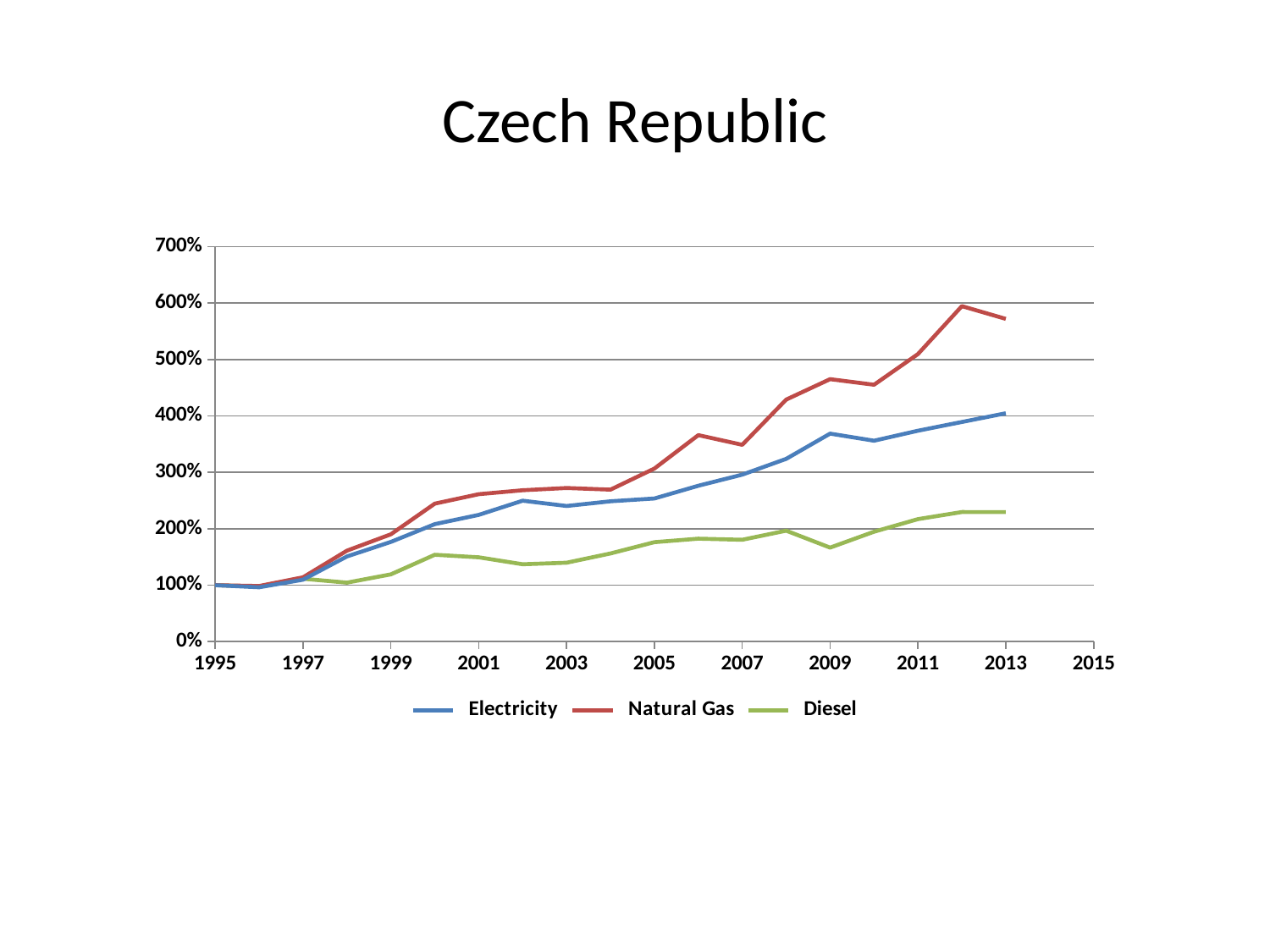
What is the value for Electricity in 1995? 100% What is the title of the chart? Czech Republic Does the Natural Gas line generally rise or fall from 1995 to 2013? rise Is the value for Electricity in 2013 greater or less than 300%? greater Which is larger in 2005, the value for Electricity or the value for Diesel? Electricity Which series has the lowest value in 2013? Diesel How many series does the legend list? 3 Is the value for Natural Gas in 2012 greater or less than 500%? greater What colour is the Diesel line? green What kind of chart is shown on the slide? line chart Which series has the highest value in 2013? Natural Gas Is the value for Diesel in 2013 greater or less than 300%? less